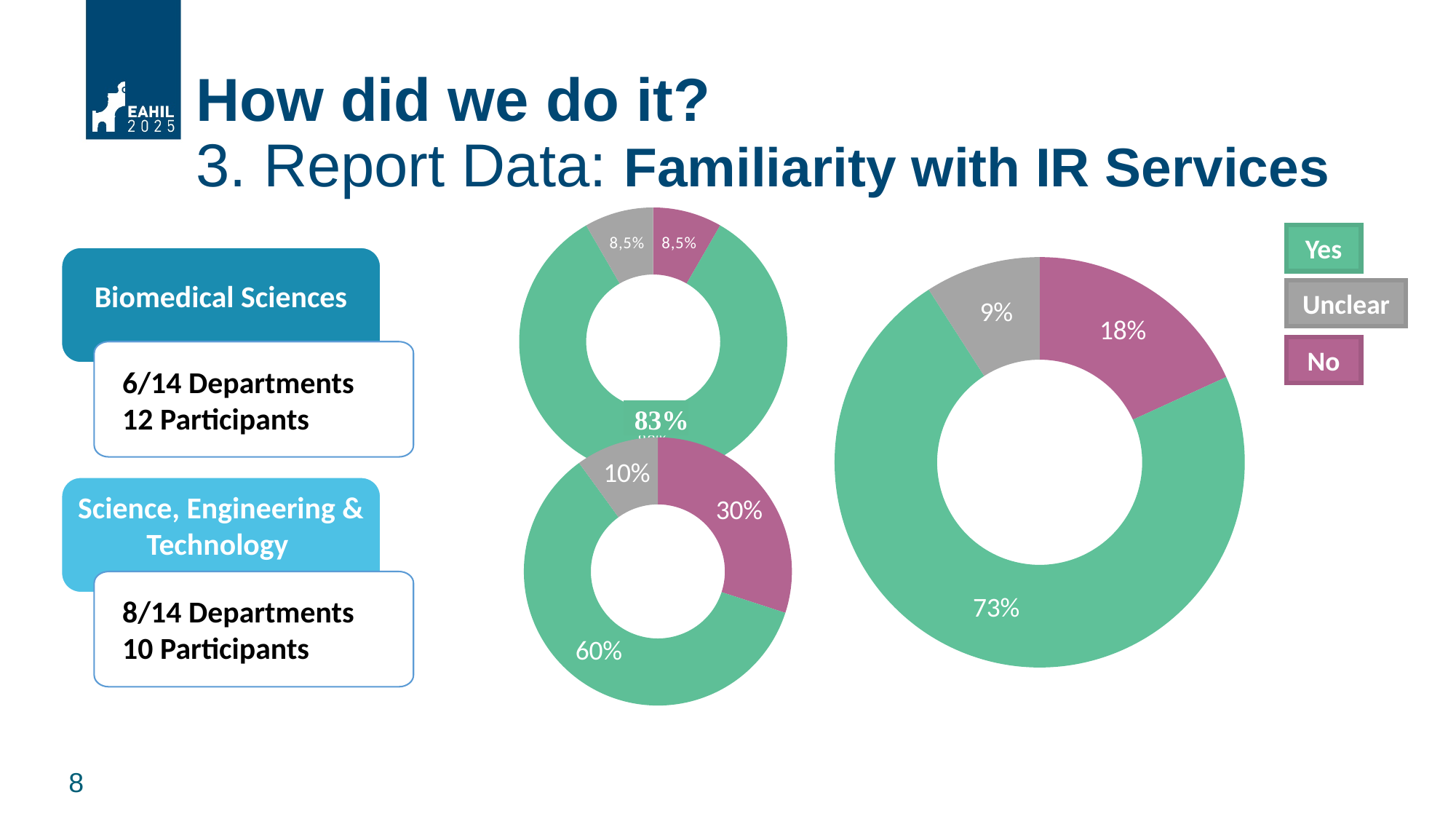
In the large donut chart on the right, which segment is the smallest? Unclear How many categories does the legend list? 3 In the top-left donut chart, what share is labelled for the Unclear (grey) segment? 8,5% In the large donut chart on the right, what share is labelled for the No (pink) segment? 18% In the large donut chart on the right, what share is labelled for the Yes (green) segment? 73% In the bottom-left donut chart, what is the difference between the Yes share and the No share? 30% In the large donut chart on the right, what share is labelled for the Unclear (grey) segment? 9% What kind of charts are shown on the slide? Donut (pie) charts In the bottom-left donut chart, what share is labelled for the Yes (green) segment? 60% In the bottom-left donut chart, what share is labelled for the No (pink) segment? 30% In the top-left donut chart, what share is labelled for the Yes (green) segment? 83% In the large donut chart on the right, which segment is the largest? Yes